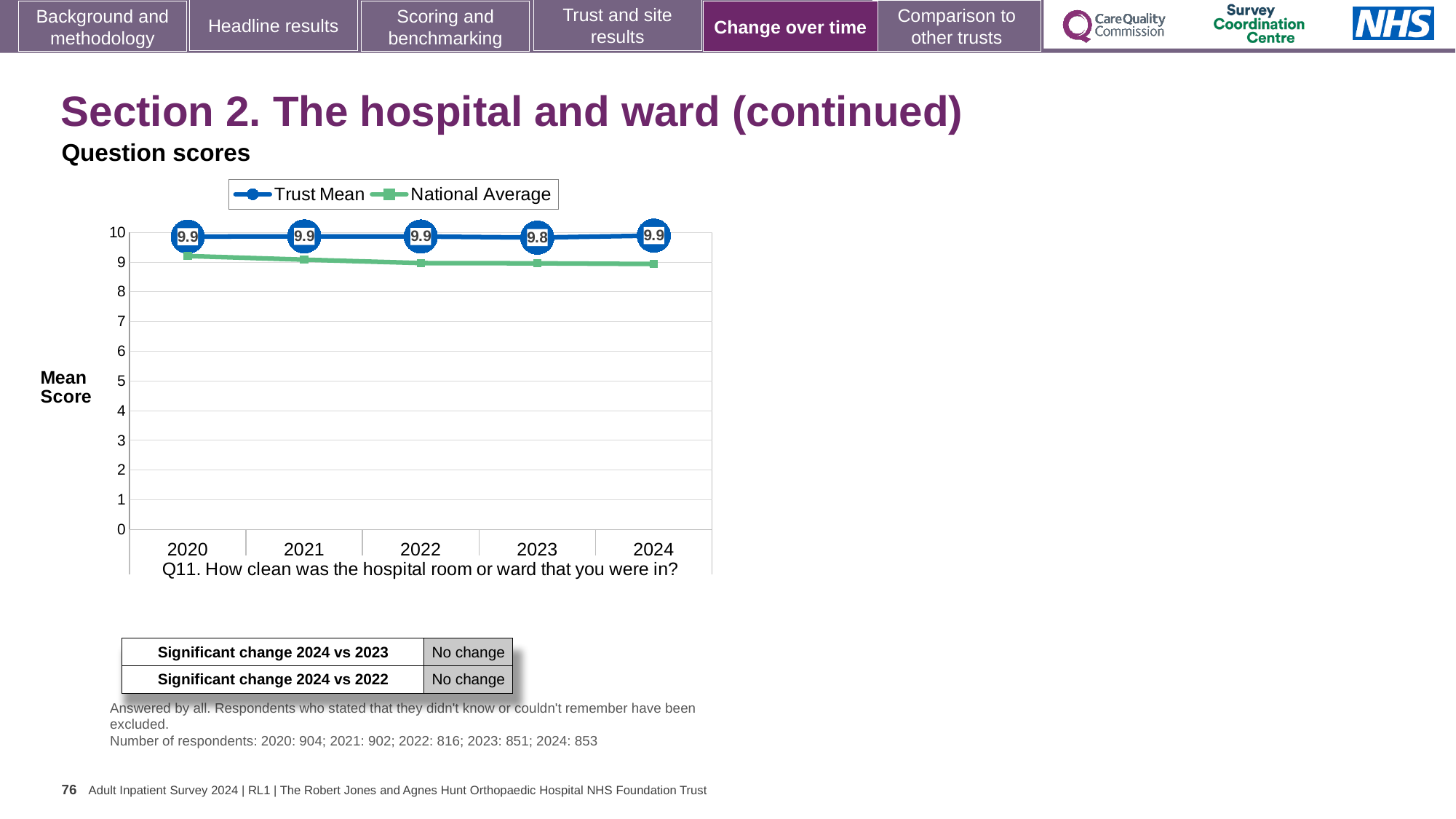
What is the difference between the Trust Mean in 2022 and in 2023? 0.1 In 2024, which is larger: the Trust Mean or the National Average? Trust Mean What is the Trust Mean value for 2020? 9.9 What is the Trust Mean value for 2024? 9.9 What is the Trust Mean value for 2023? 9.8 Is the National Average value for 2020 greater or less than 9? greater Which question does the chart relate to? Q11. How clean was the hospital room or ward that you were in? How many series does the legend list? 2 How many years are shown on the x axis? 5 What kind of chart is shown? Line chart Which year has the lowest Trust Mean value? 2023